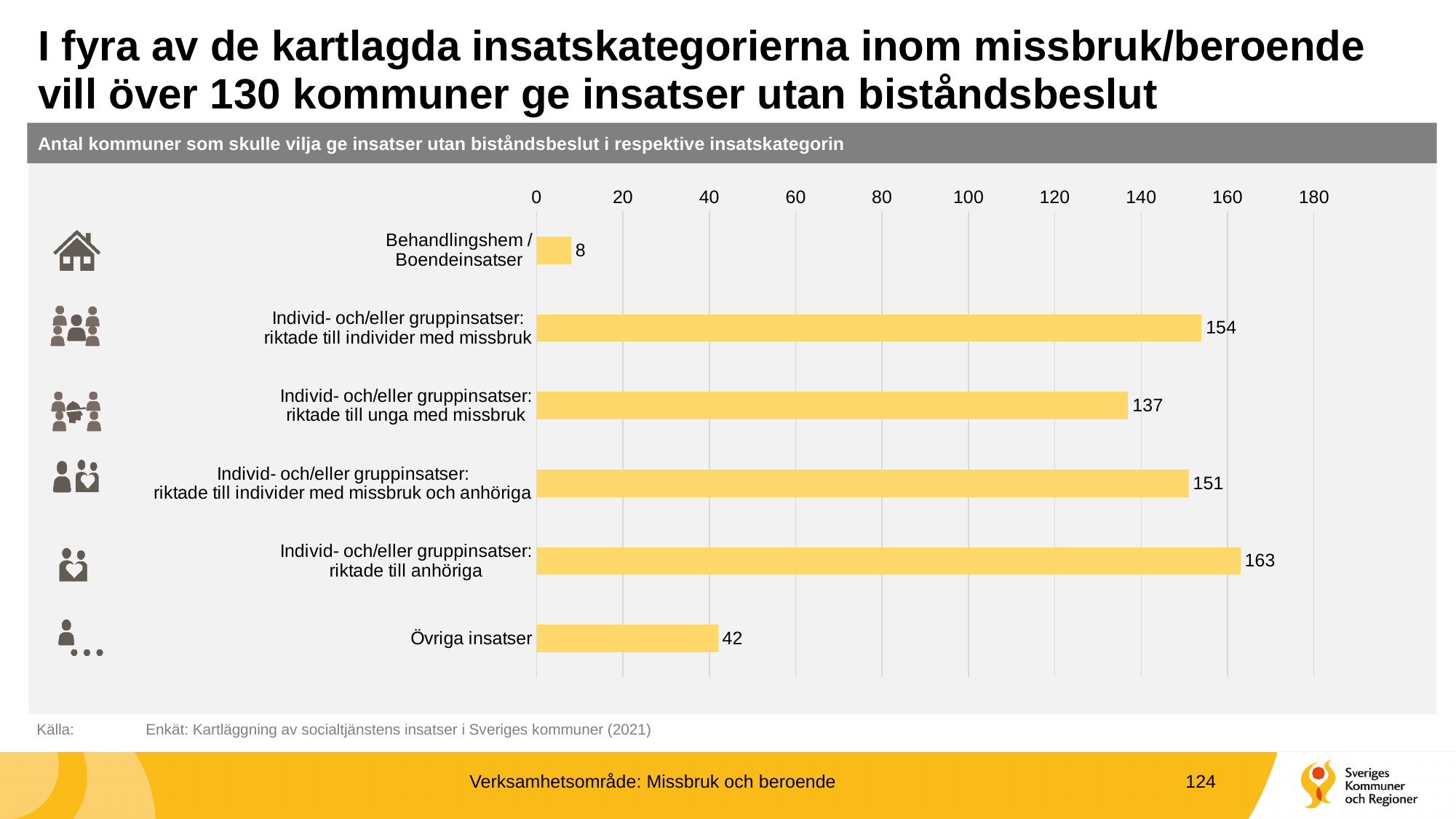
What is the title of the chart? Antal kommuner som skulle vilja ge insatser utan biståndsbeslut i respektive insatskategorin Which is larger: the value for Individ- och/eller gruppinsatser: riktade till individer med missbruk or the value for Individ- och/eller gruppinsatser: riktade till individer med missbruk och anhöriga? Individ- och/eller gruppinsatser: riktade till individer med missbruk Which category has the lowest value? Behandlingshem / Boendeinsatser Which category has the highest value? Individ- och/eller gruppinsatser: riktade till anhöriga What is the difference between the values for Övriga insatser and Behandlingshem / Boendeinsatser? 34 What is the value for Behandlingshem / Boendeinsatser? 8 What kind of chart is shown on the slide? bar chart What is the value for Övriga insatser? 42 What is the difference between the values for Individ- och/eller gruppinsatser: riktade till anhöriga and Individ- och/eller gruppinsatser: riktade till individer med missbruk? 9 What is the value for Individ- och/eller gruppinsatser: riktade till unga med missbruk? 137 How many categories are shown in the chart? 6 Is the value for Övriga insatser greater or less than 60? less